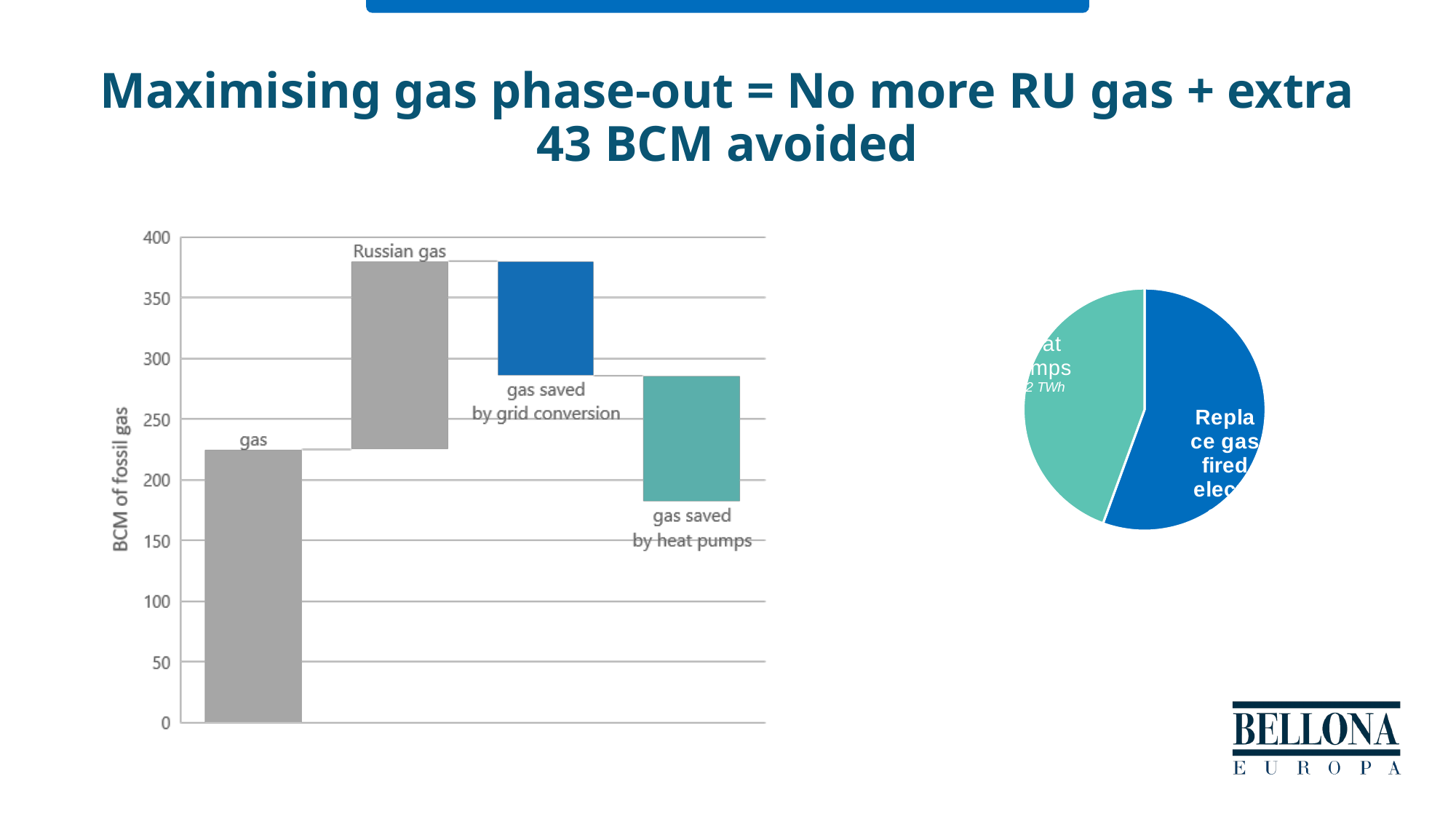
In the bar chart on the left, how many bars are plotted? 4 In the bar chart on the left, is the bottom of the 'gas saved by heat pumps' bar greater or less than 200? less In the bar chart on the left, is the top of the 'Russian gas' bar greater or less than 350? greater In the bar chart on the left, is the top of the 'gas' bar greater or less than 200? greater In the bar chart on the left, what is the label of the vertical axis? BCM of fossil gas What kind of chart is the chart on the left of the slide? bar chart What kind of chart is the chart on the right of the slide? pie chart In the bar chart on the left, what is the highest value shown on the vertical axis? 400 In the pie chart on the right, how many slices are there? 2